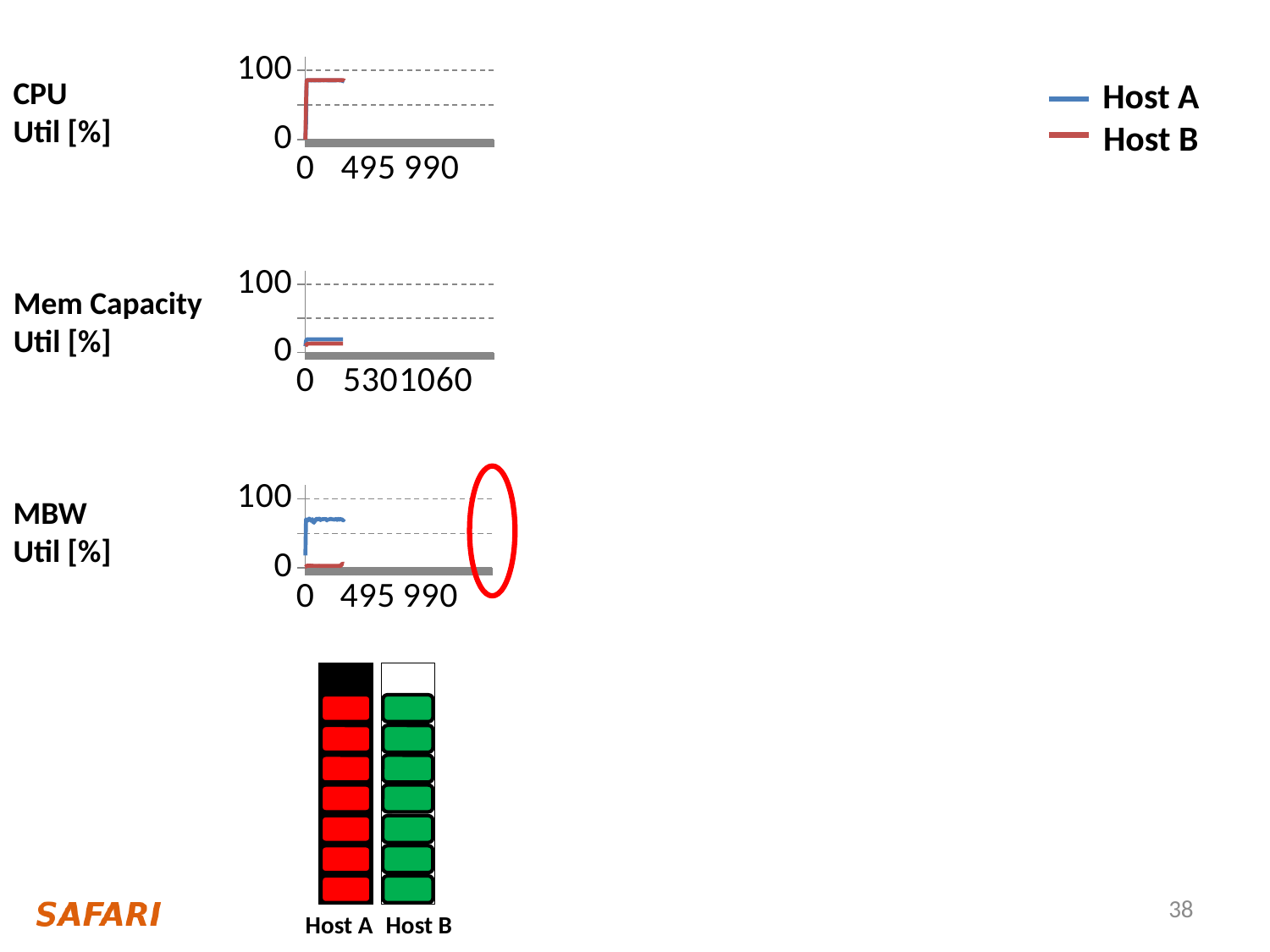
Which colour represents Host B in the legend? red In the CPU Util [%] chart, is the value for Host B after the initial rise greater or less than 50? greater In the Mem Capacity Util [%] chart, is the value for Host A greater or less than 50? less In the MBW Util [%] chart, is the value for Host A after the initial rise greater or less than 50? greater What kind of chart is the CPU Util [%] chart? line chart How many series does the legend list for the charts? 2 What is the largest tick label on the x axis of the CPU Util [%] chart? 990 What is the highest value labeled on the y axis of the MBW Util [%] chart? 100 In the MBW Util [%] chart, which host has the higher utilization, Host A or Host B? Host A What is the largest tick label on the x axis of the Mem Capacity Util [%] chart? 1060